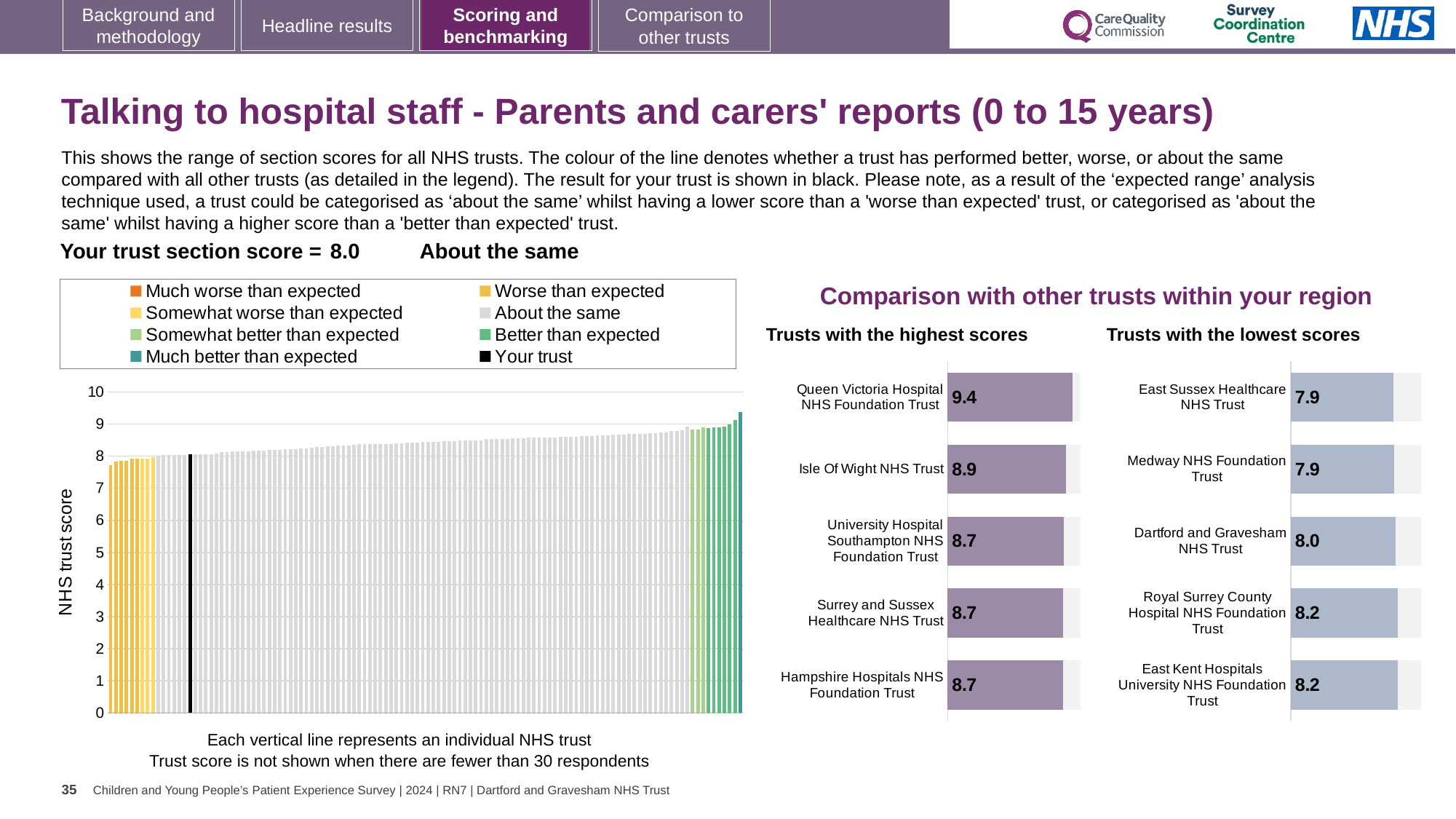
In the main 'NHS trust score' chart on the left, is the value of the tallest bar at the far right greater or less than 9? greater How many entries does the legend of the main 'NHS trust score' chart list? 8 In the 'Trusts with the highest scores' chart, what is the difference between the scores of Queen Victoria Hospital NHS Foundation Trust and Isle Of Wight NHS Trust? 0.5 In the 'Trusts with the lowest scores' chart, what is the score for Dartford and Gravesham NHS Trust? 8.0 What kind of chart is the main 'NHS trust score' chart on the left? bar chart In the main 'NHS trust score' chart on the left, do the bar values rise or fall from left to right? rise In the 'Trusts with the highest scores' chart, which trust has the highest score? Queen Victoria Hospital NHS Foundation Trust Which is larger: the score for Queen Victoria Hospital NHS Foundation Trust in the highest scores chart, or the score for East Sussex Healthcare NHS Trust in the lowest scores chart? Queen Victoria Hospital NHS Foundation Trust How many trusts are shown in the 'Trusts with the highest scores' chart? 5 In the 'Trusts with the highest scores' chart, what is the score for Queen Victoria Hospital NHS Foundation Trust? 9.4 In the 'Trusts with the lowest scores' chart, what is the score for East Sussex Healthcare NHS Trust? 7.9 How many trusts are shown in the 'Trusts with the lowest scores' chart? 5